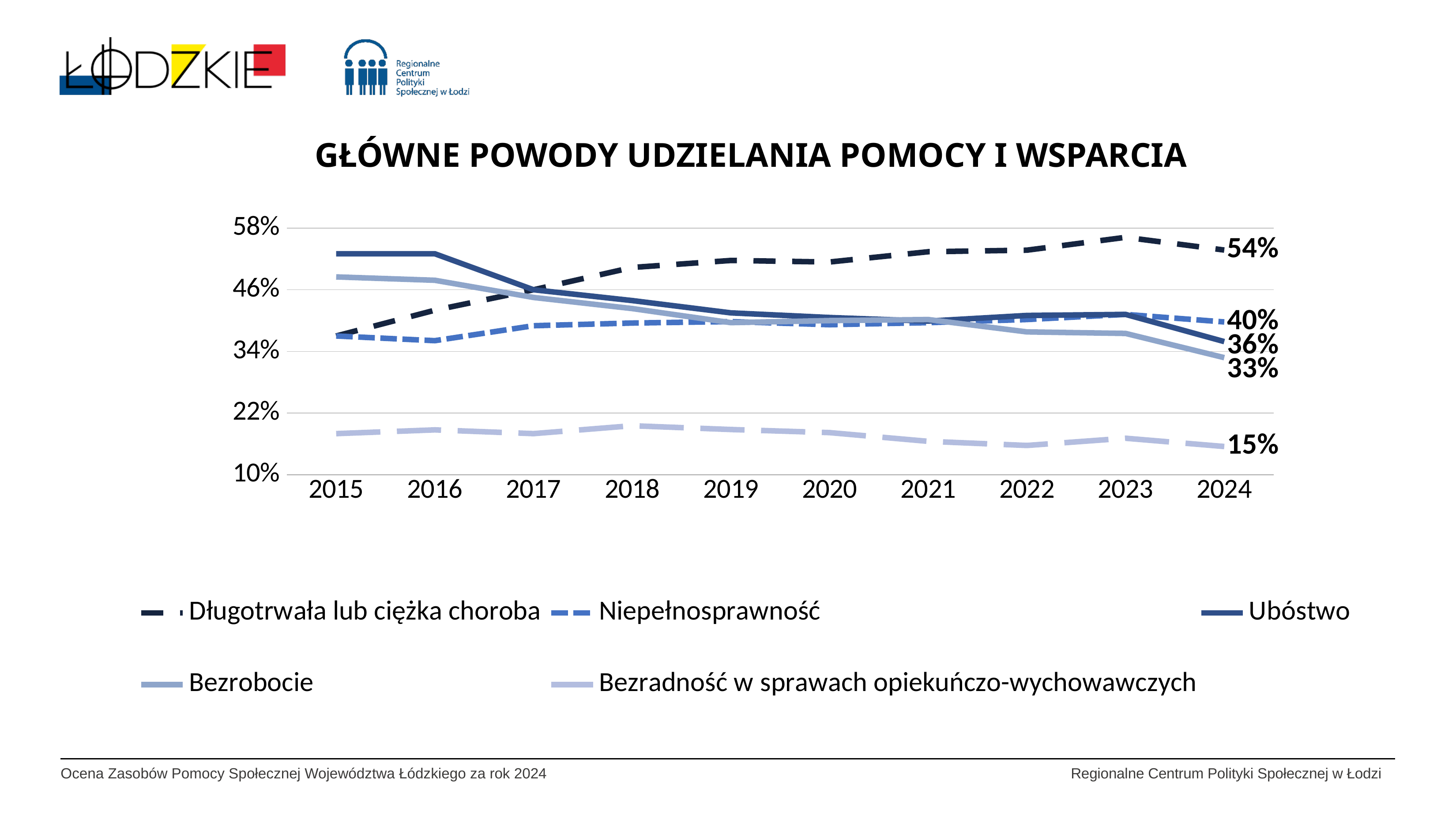
Which series has the lowest value in 2024? Bezradność w sprawach opiekuńczo-wychowawczych What is the value for Niepełnosprawność in 2024? 40% What is the value for Ubóstwo in 2024? 36% Does the value for Długotrwała lub ciężka choroba rise or fall from 2015 to 2024? rise Which series has the highest value in 2024? Długotrwała lub ciężka choroba What is the difference between the 2024 values for Długotrwała lub ciężka choroba and Bezradność w sprawach opiekuńczo-wychowawczych? 39 percentage points What is the value for Bezradność w sprawach opiekuńczo-wychowawczych in 2024? 15% What is the value for Długotrwała lub ciężka choroba in 2024? 54% Is the value for Ubóstwo in 2015 greater or less than 46%? greater How many series does the legend list? 5 In 2024, which is larger: Ubóstwo or Bezrobocie? Ubóstwo How many years are shown on the x axis? 10